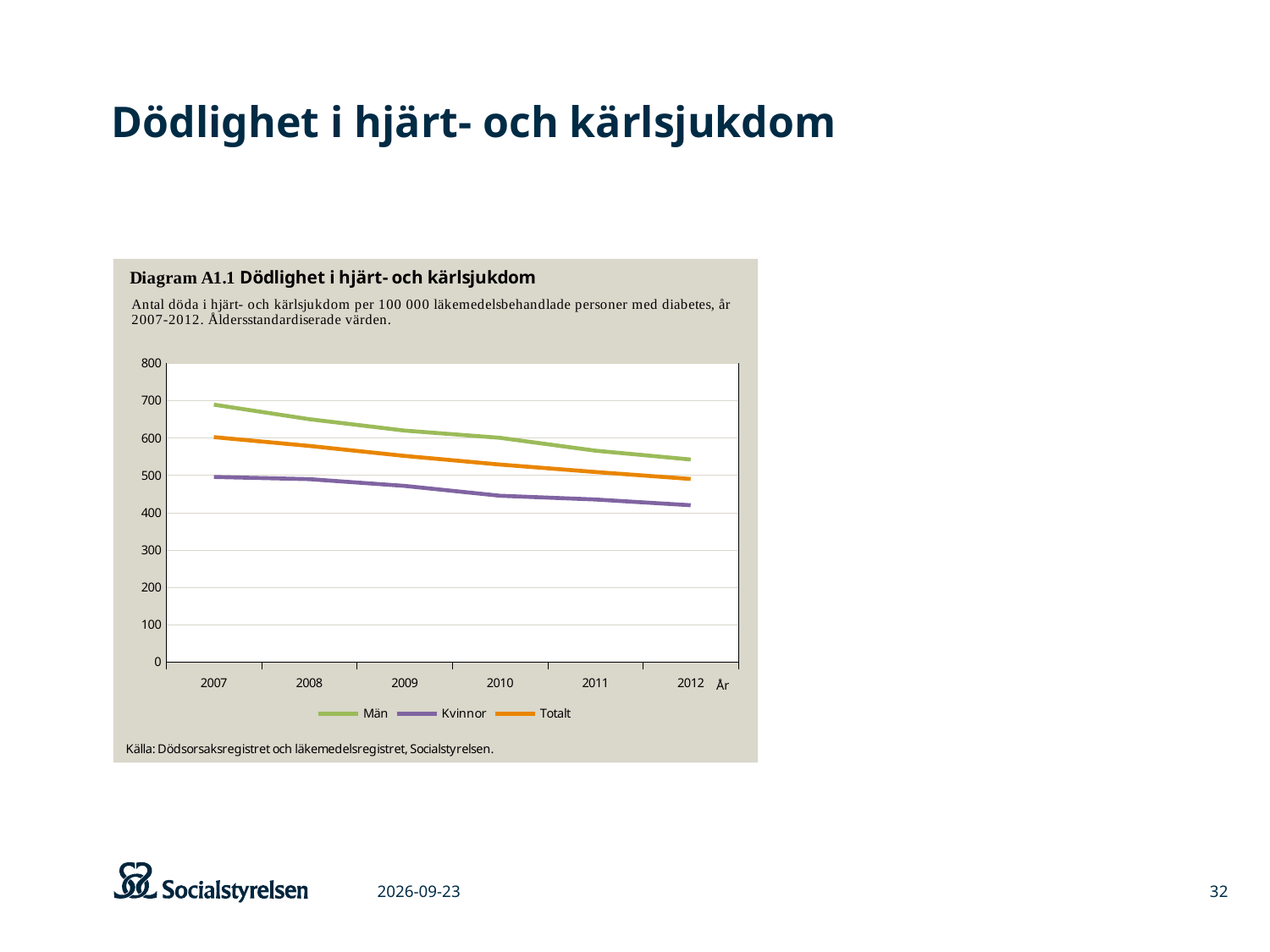
What is the title of the diagram shown on the slide? Diagram A1.1 Dödlighet i hjärt- och kärlsjukdom How many years are plotted along the x axis? 6 In 2010, which is larger: the value for Män or the value for Kvinnor? Män Which series has the lowest values throughout the period? Kvinnor Is the value for Totalt in 2012 greater or less than 600? less What label is shown at the end of the x axis? År Is the value for Män in 2007 greater or less than 600? greater How many series does the legend list? 3 Do the values for Män rise or fall from 2007 to 2012? fall Is the value for Kvinnor in 2012 greater or less than 500? less Which series has the highest values throughout the period? Män What kind of chart is shown on the slide? line chart